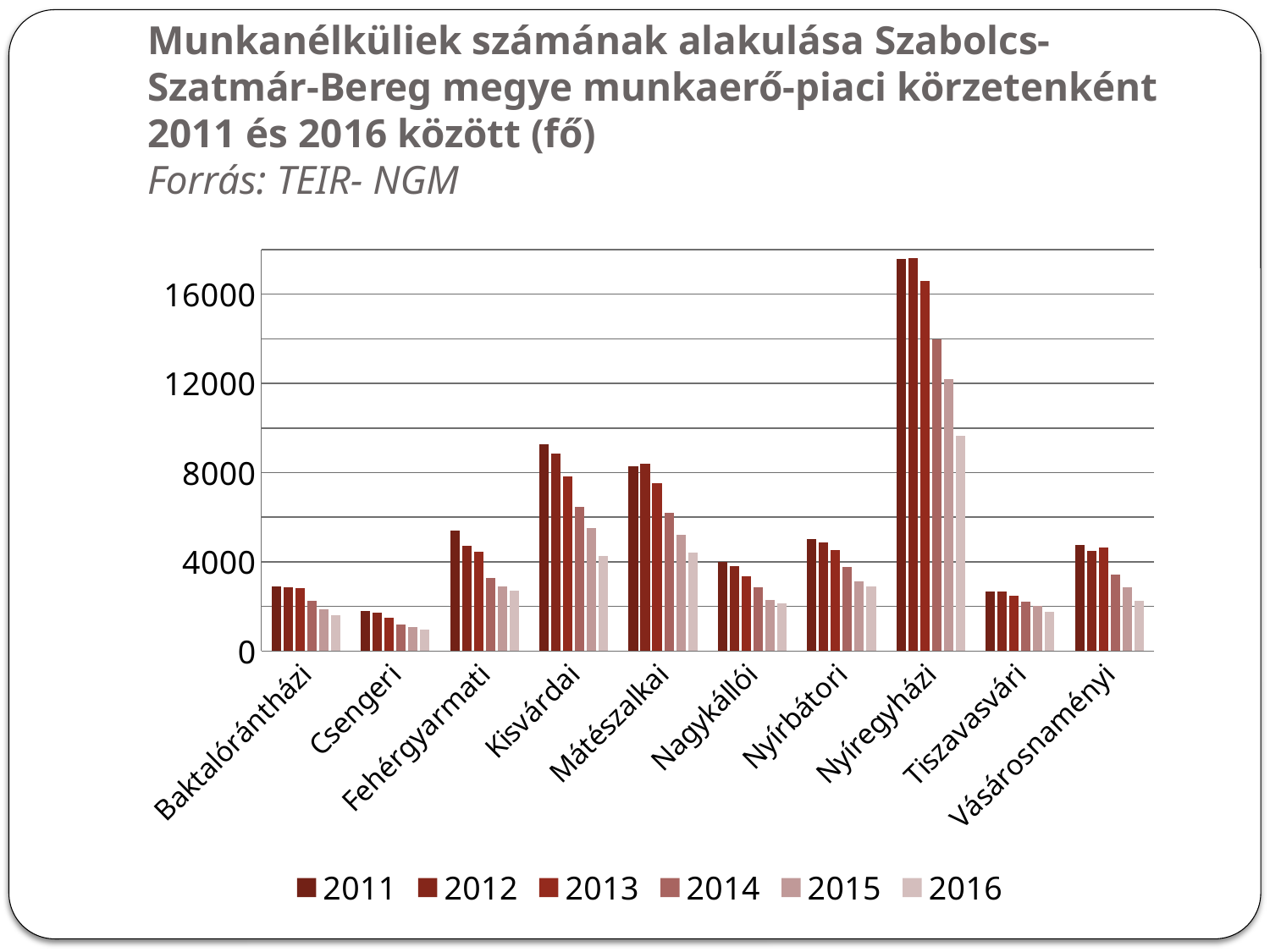
Is the 2011 value for Kisvárdai greater or less than 8000? greater Is the 2011 value for Fehérgyarmati greater or less than 4000? greater How many labour-market districts (categories) are shown on the x axis? 10 How many series does the legend list? 6 Which district has the lowest number of unemployed in 2011? Csengeri Do the values for Kisvárdai rise or fall from 2011 to 2016? fall What source is cited below the chart title? TEIR- NGM Is the 2016 value for Nyíregyházi greater or less than 12000? less Which is larger, the 2011 value for Kisvárdai or the 2011 value for Mátészalkai? Kisvárdai Which district has the highest number of unemployed in 2011? Nyíregyházi What kind of chart is shown on the slide? bar chart